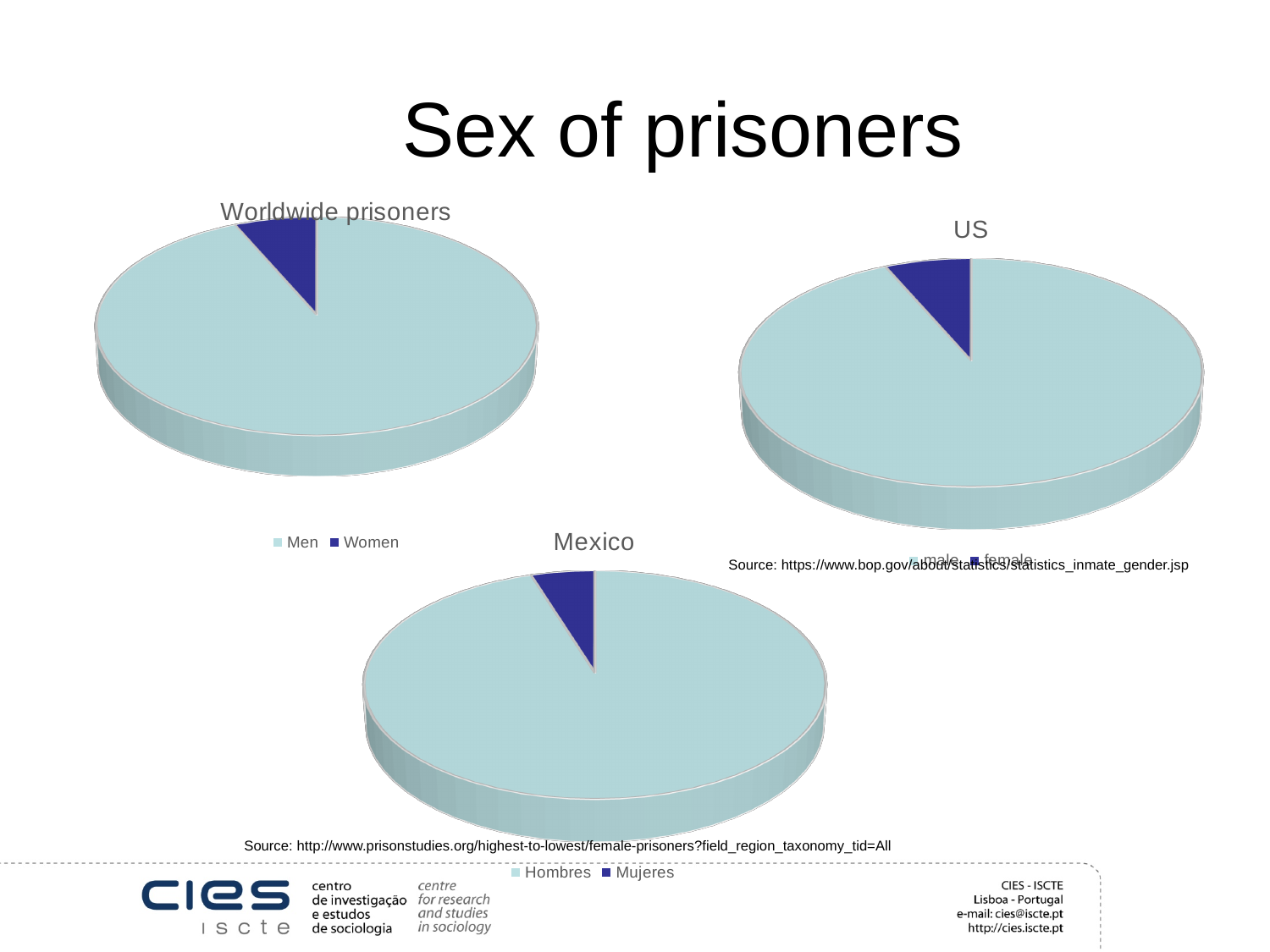
In the "Mexico" chart, which category has the larger share? Hombres How many pie charts are shown on the slide? 3 In the "Worldwide prisoners" chart, which category has the smaller share? Women How many slices does the "Worldwide prisoners" pie chart have? 2 In the "US" chart, which category has the smaller share? female In the "Mexico" chart, is the share for Hombres larger or smaller than the share for Mujeres? larger How many entries does the legend of the "Worldwide prisoners" chart list? 2 In the "Worldwide prisoners" chart, which category has the larger share? Men What kind of chart is the "Mexico" chart? pie chart In the "US" chart, which category has the larger share? male What kind of chart is the "Worldwide prisoners" chart? pie chart What are the two legend entries of the "Mexico" chart? Hombres and Mujeres